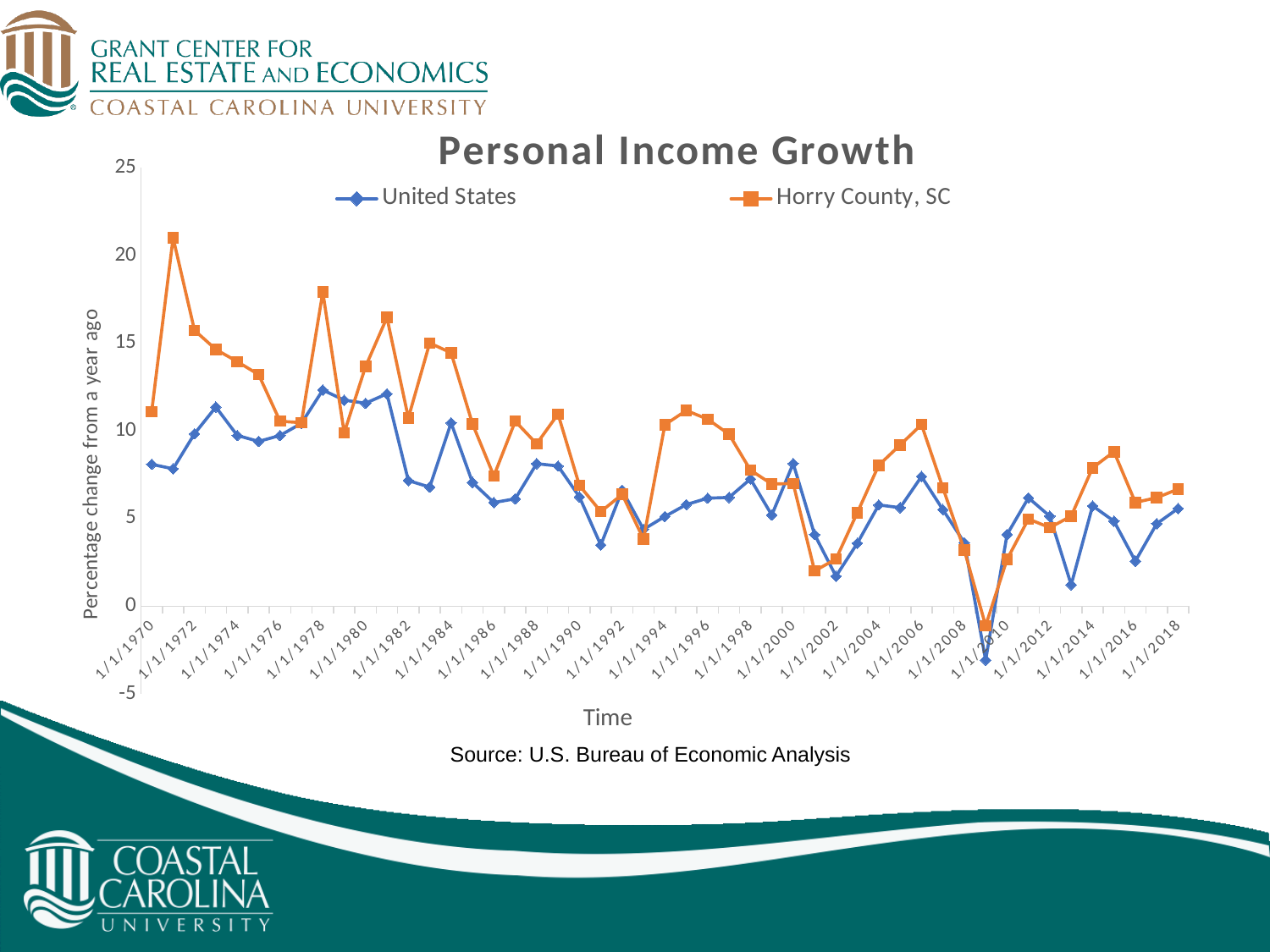
Is the value for United States at 1/1/1992 greater or less than 5? greater Which series has the higher value at 1/1/1978, United States or Horry County, SC? Horry County, SC What kind of chart is shown on the slide? Line chart Is the value for United States at 1/1/1978 greater or less than 10? greater What is the label on the vertical axis? Percentage change from a year ago Is the value for Horry County, SC at 1/1/1978 greater or less than 15? greater Which series reaches the highest value anywhere on the chart? Horry County, SC Overall, do the values for Horry County, SC rise or fall from 1/1/1970 to 1/1/2018? fall How many series does the legend list? 2 What is the title of the chart? Personal Income Growth